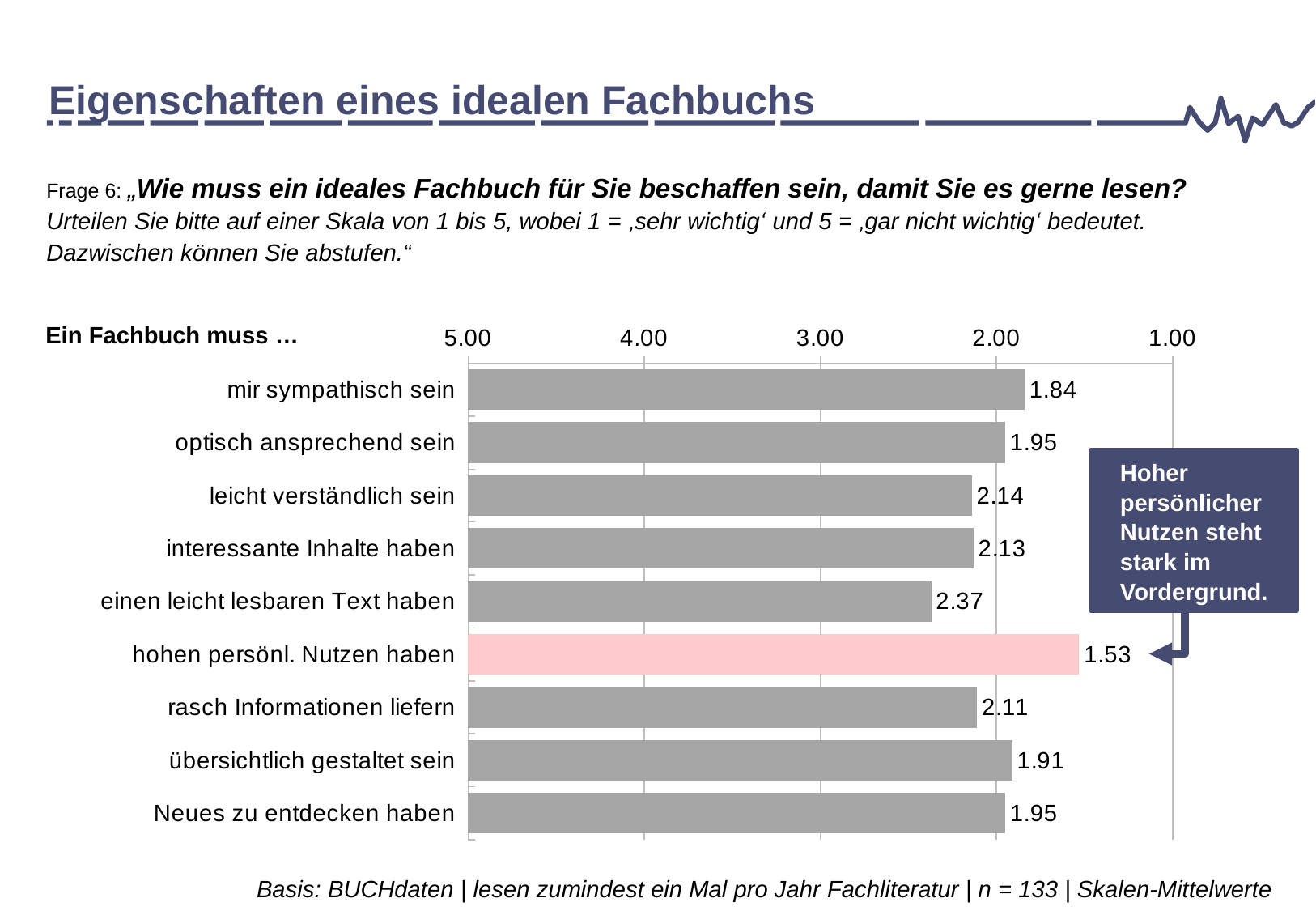
Which bar is highlighted in a different colour (pink) from the others? hohen persönl. Nutzen haben What is the value for "mir sympathisch sein"? 1.84 Which has the larger value, "übersichtlich gestaltet sein" or "leicht verständlich sein"? leicht verständlich sein What is the value for "hohen persönl. Nutzen haben"? 1.53 What kind of chart is shown on the slide? bar chart What is the difference between the values for "einen leicht lesbaren Text haben" and "hohen persönl. Nutzen haben"? 0.84 What is the value for "rasch Informationen liefern"? 2.11 What is the value for "einen leicht lesbaren Text haben"? 2.37 What is the sample size (n) stated in the footnote below the chart? n = 133 How many categories are shown in the chart? 9 Which category has the lowest numerical value? hohen persönl. Nutzen haben Which category has the highest numerical value? einen leicht lesbaren Text haben